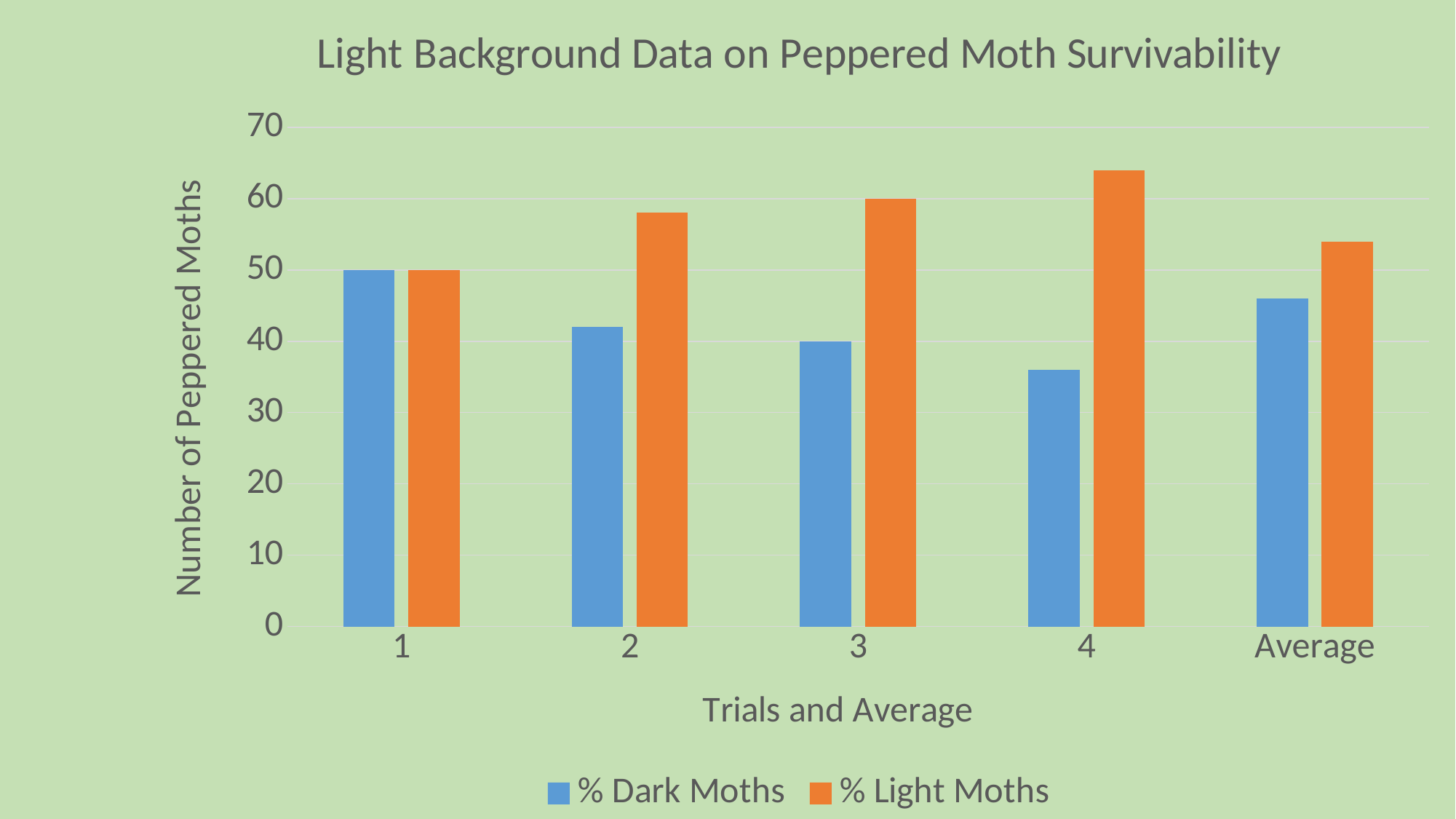
What is the value for % Dark Moths in trial 1? 50 Is the value for % Light Moths in trial 4 greater or less than 60? greater How many series does the legend list? 2 What is the value for % Dark Moths in trial 3? 40 Which trial has the lowest value for % Dark Moths? 4 What is the title of the chart? Light Background Data on Peppered Moth Survivability What type of chart is shown on the slide? bar chart Do the % Dark Moths values rise or fall from trial 1 to trial 4? fall What is the value for % Light Moths in trial 3? 60 How many categories are shown on the x axis? 5 Which trial has the highest value for % Light Moths? 4 Is the value for % Dark Moths in trial 4 greater or less than 40? less